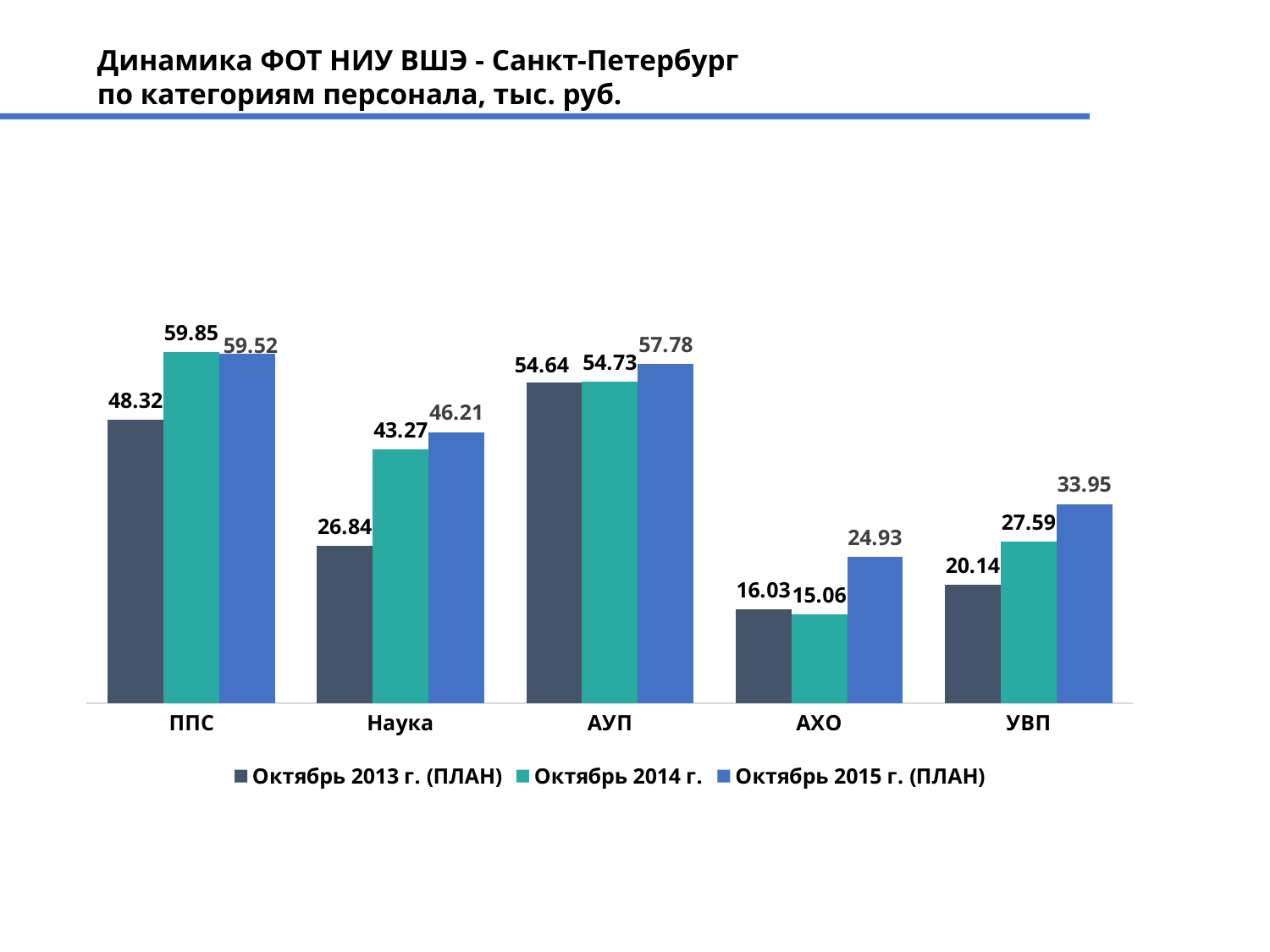
What unit is stated in the chart title? тыс. руб. What is the value for ППС in the Октябрь 2014 г. series? 59.85 What is the difference between the Октябрь 2014 г. and Октябрь 2013 г. (ПЛАН) values for Наука? 16.43 How many categories are shown on the x axis? 5 Which category has the lowest value in the Октябрь 2014 г. series? АХО How many series does the legend list? 3 What is the value for Наука in the Октябрь 2013 г. (ПЛАН) series? 26.84 What kind of chart is shown on the slide? Bar chart What is the difference between the Октябрь 2015 г. (ПЛАН) and Октябрь 2013 г. (ПЛАН) values for УВП? 13.81 Which category has the highest value in the Октябрь 2015 г. (ПЛАН) series? ППС What is the value for АХО in the Октябрь 2015 г. (ПЛАН) series? 24.93 For АУП, which is larger: the Октябрь 2015 г. (ПЛАН) value or the Октябрь 2013 г. (ПЛАН) value? Октябрь 2015 г. (ПЛАН)